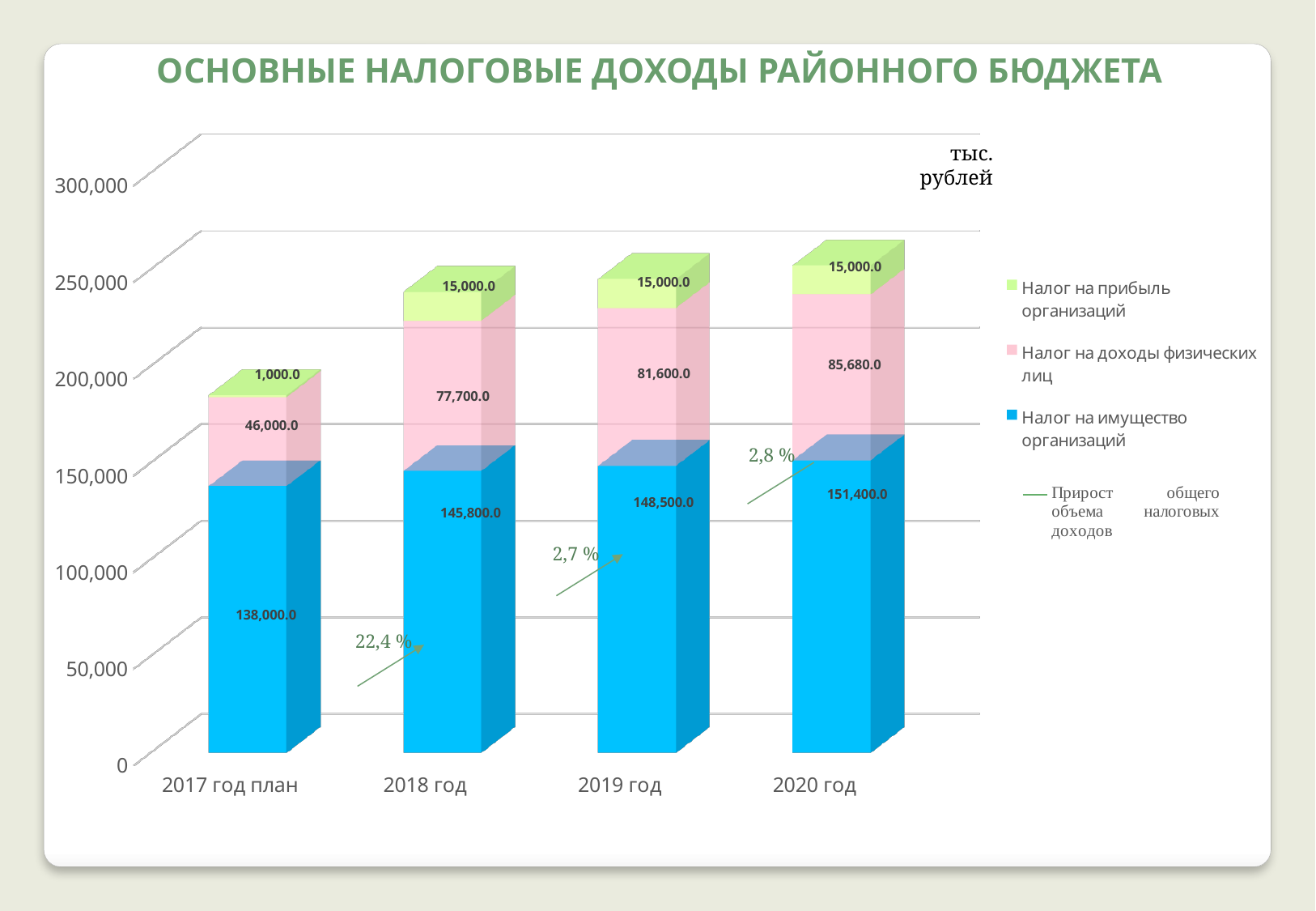
What growth percentage is annotated between 2017 год план and 2018 год? 22,4 % What is the total of the stacked bar for 2017 год план? 185,000.0 What is the total of the stacked bar for 2018 год? 238,500.0 Which year has the highest value for Налог на доходы физических лиц? 2020 год What is the value of Налог на прибыль организаций for 2017 год план? 1,000.0 What kind of chart is shown on the slide? Stacked bar chart What is the value of Налог на доходы физических лиц for 2020 год? 85,680.0 Which year has the lowest value for Налог на имущество организаций? 2017 год план Which is larger: Налог на доходы физических лиц in 2018 год or in 2019 год? 2019 год What is the value of Налог на имущество организаций for 2018 год? 145,800.0 What is the difference between Налог на имущество организаций in 2020 год and in 2019 год? 2,900.0 How many years (categories) are shown on the x axis? 4